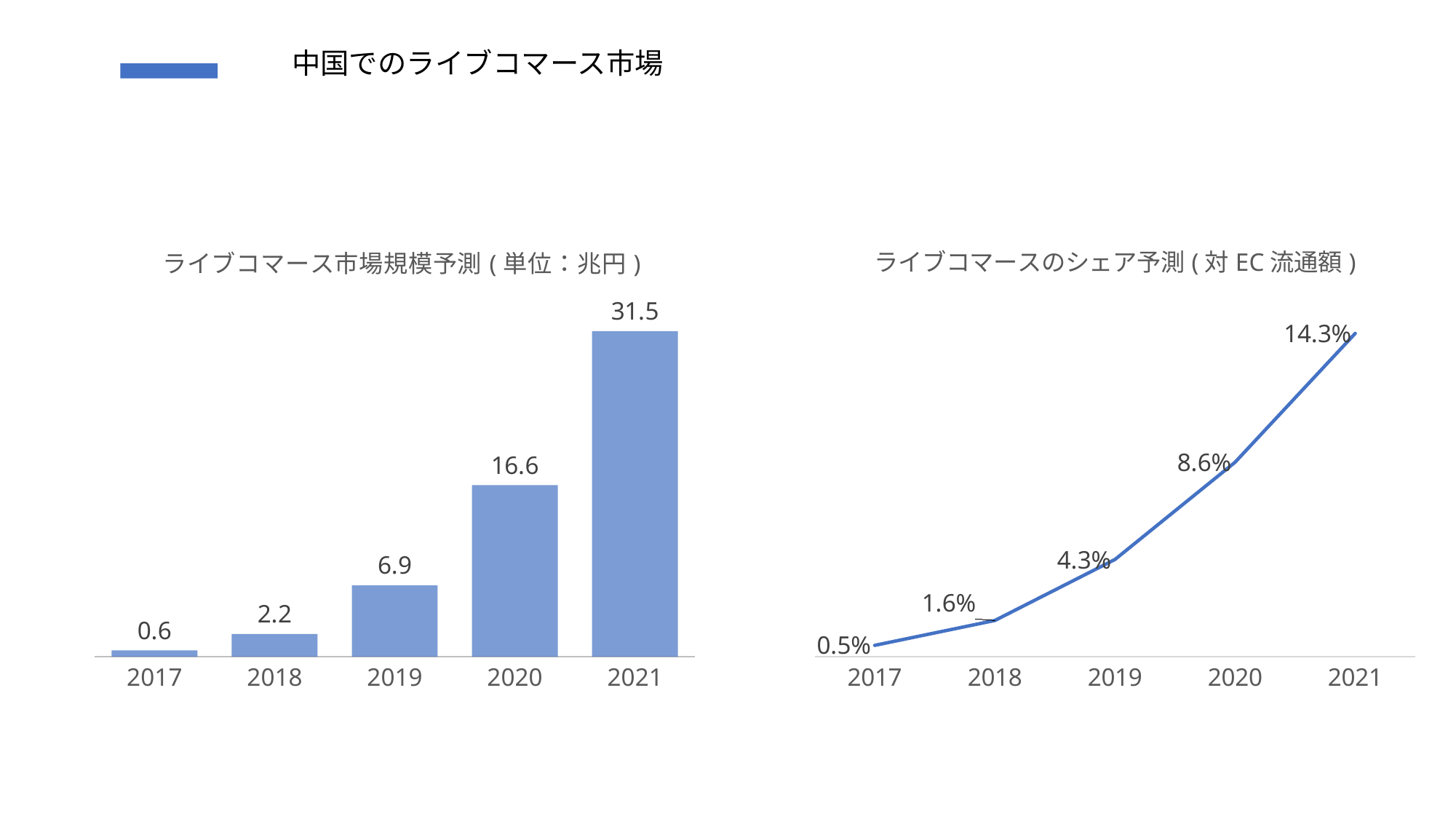
In the right chart (ライブコマースのシェア予測), do the values rise or fall from 2017 to 2021? Rise In the right chart (ライブコマースのシェア予測), what is the value for 2019? 4.3% In the left chart (ライブコマース市場規模予測), what is the value for 2017? 0.6 In the right chart (ライブコマースのシェア予測), what is the value for 2021? 14.3% In the right chart (ライブコマースのシェア予測), what is the difference between the 2020 and 2018 values? 7.0% In the left chart (ライブコマース市場規模予測), which year has the highest value? 2021 In the right chart (ライブコマースのシェア予測), what kind of chart is shown? Line chart In the left chart (ライブコマース市場規模予測), how many years are plotted? 5 In the left chart (ライブコマース市場規模予測), what is the difference between the 2021 and 2020 values? 14.9 In the left chart (ライブコマース市場規模予測), which year has the lowest value? 2017 In the left chart (ライブコマース市場規模予測), what is the value for 2020? 16.6 In the left chart (ライブコマース市場規模予測), what kind of chart is shown? Bar chart